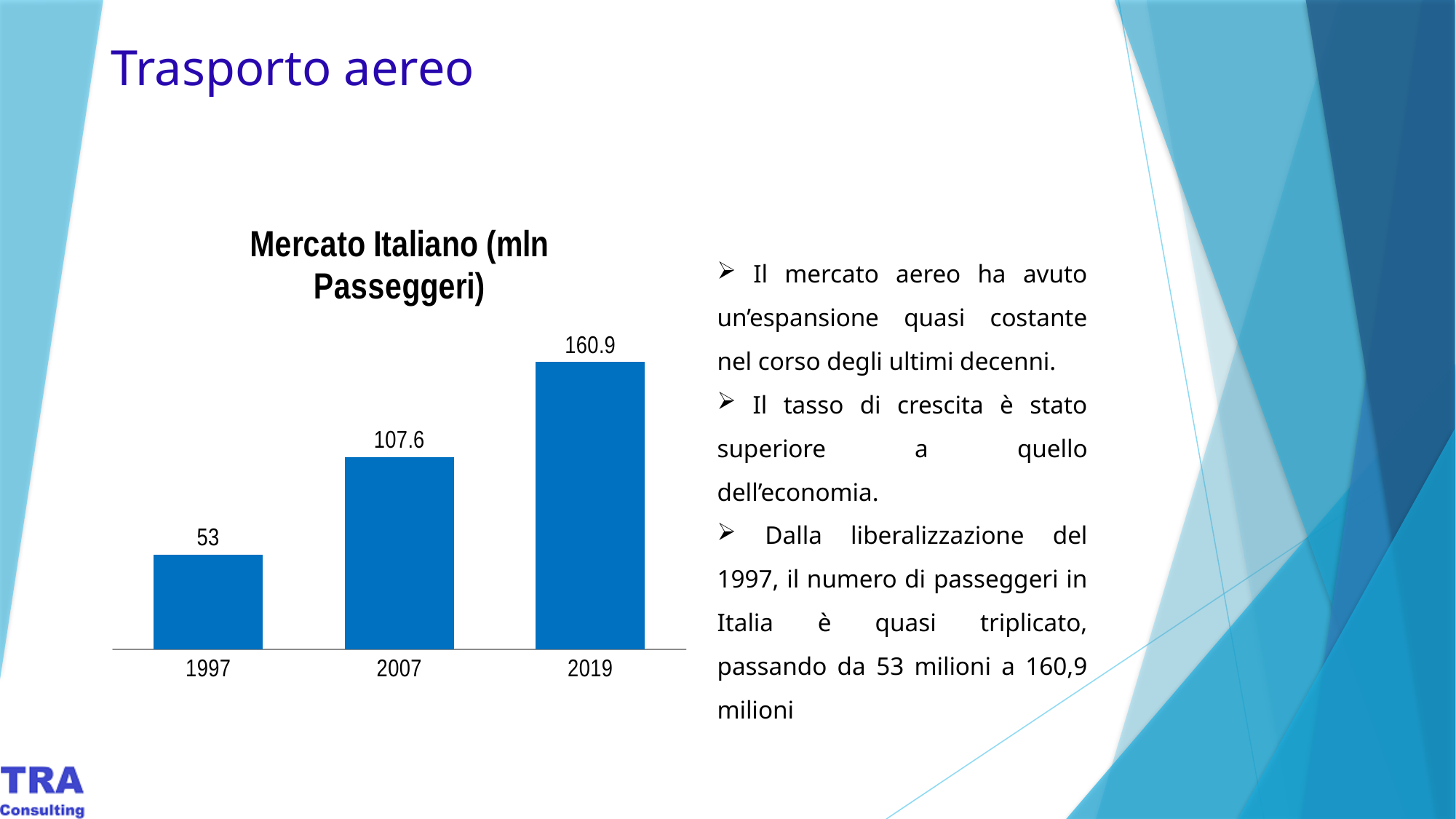
What is the value for 1997 in the chart? 53 What is the value for 2019 in the chart? 160.9 What kind of chart is shown on the slide? Bar chart What is the title of the chart? Mercato Italiano (mln Passeggeri) What is the value for 2007 in the chart? 107.6 Do the values rise or fall from 1997 to 2019? Rise Which year has the highest value in the chart? 2019 Which year has the lowest value in the chart? 1997 What is the difference between the values for 2019 and 1997? 107.9 How many years are shown in the chart? 3 Which is larger, the value for 2007 or the value for 2019? 2019 What is the difference between the values for 2007 and 1997? 54.6